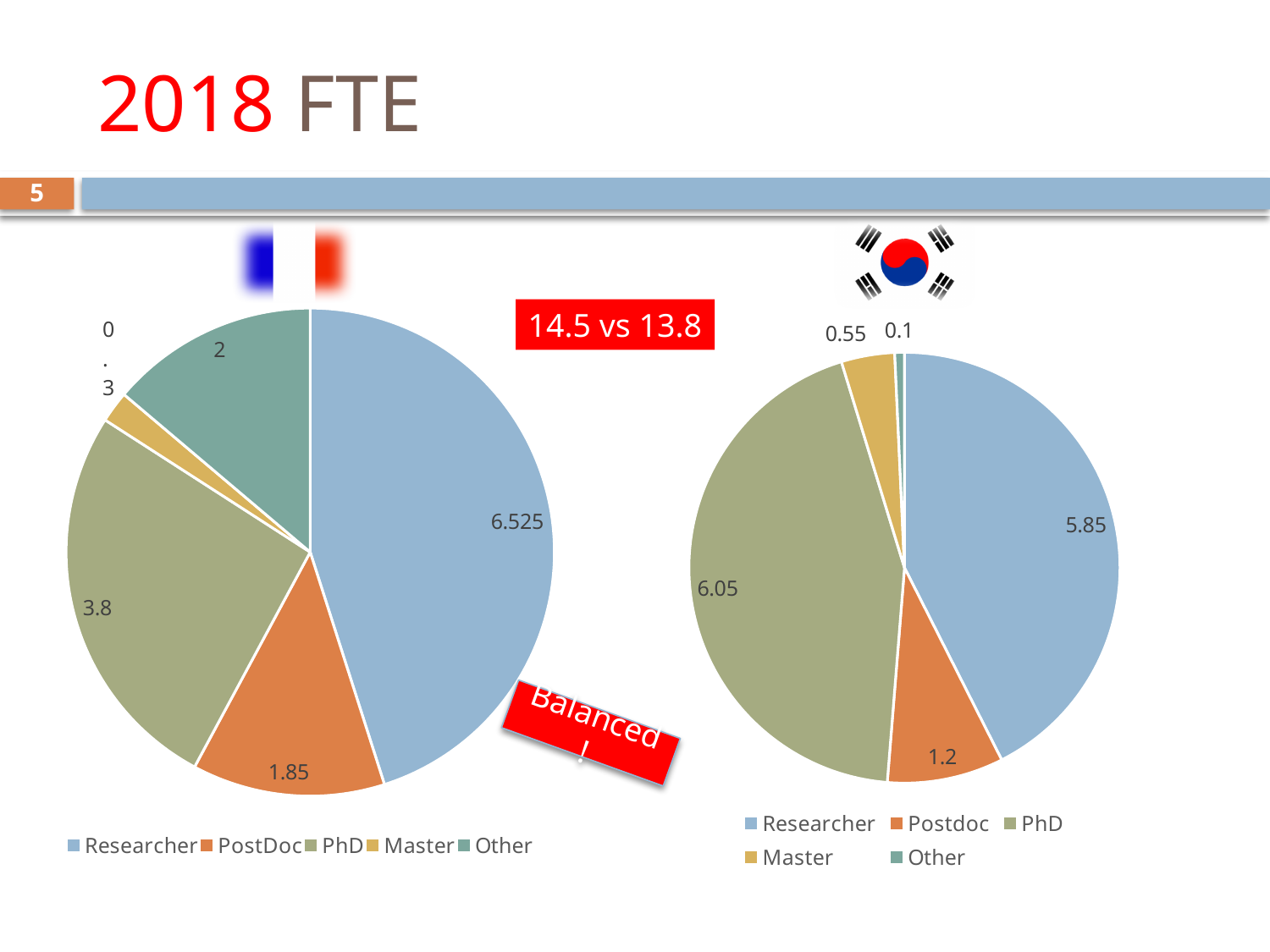
In the right pie chart, what is the difference between the Postdoc value and the Other value? 1.1 In the left pie chart, which category has the largest value? Researcher Which is larger: the Other value in the left pie chart or the Other value in the right pie chart? Left pie chart (2) In the right pie chart, which category has the smallest value? Other How many categories does the right pie chart's legend list? 5 In the right pie chart, what is the value for PhD? 6.05 In the left pie chart, what is the difference between the Researcher value and the PhD value? 2.725 In the left pie chart, what is the value for PhD? 3.8 What is the total of all values in the right pie chart? 13.75 What type of chart is shown on the left side of the slide? Pie chart In the right pie chart, what is the value for Master? 0.55 In the left pie chart, what is the value for Researcher? 6.525